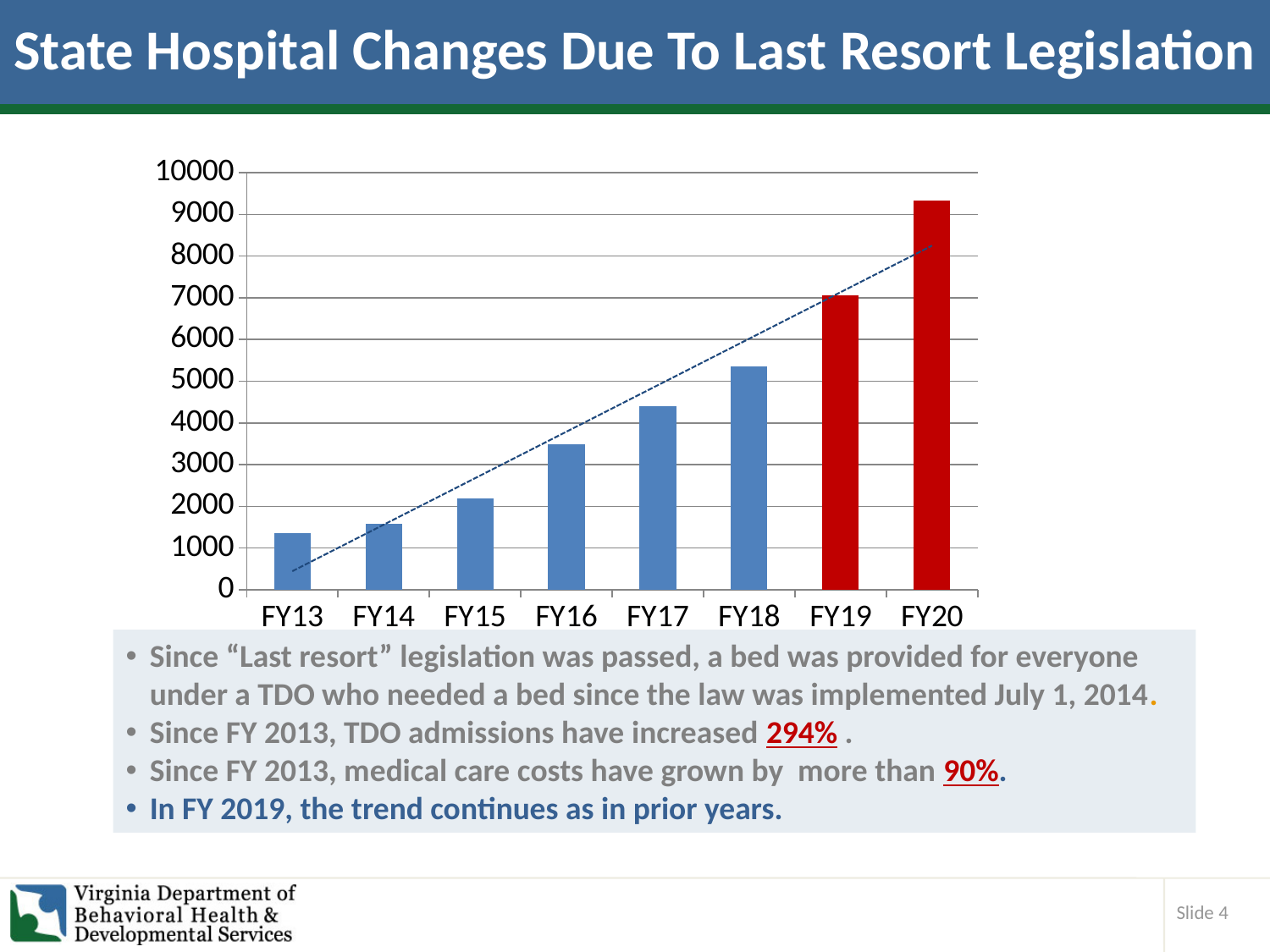
Which fiscal years are shown with red bars instead of blue bars? FY19 and FY20 Is the value for FY13 greater or less than 2000? less What kind of chart is shown on the slide? bar chart Is the value for FY18 greater or less than 5000? greater Is the value for FY16 greater or less than 3000? greater Which fiscal year has the highest bar in the chart? FY20 Which fiscal year has the lowest bar in the chart? FY13 Which is larger, the value for FY17 or the value for FY15? FY17 Do the bar values rise or fall from FY13 to FY20? rise How many fiscal years are plotted on the x axis of the chart? 8